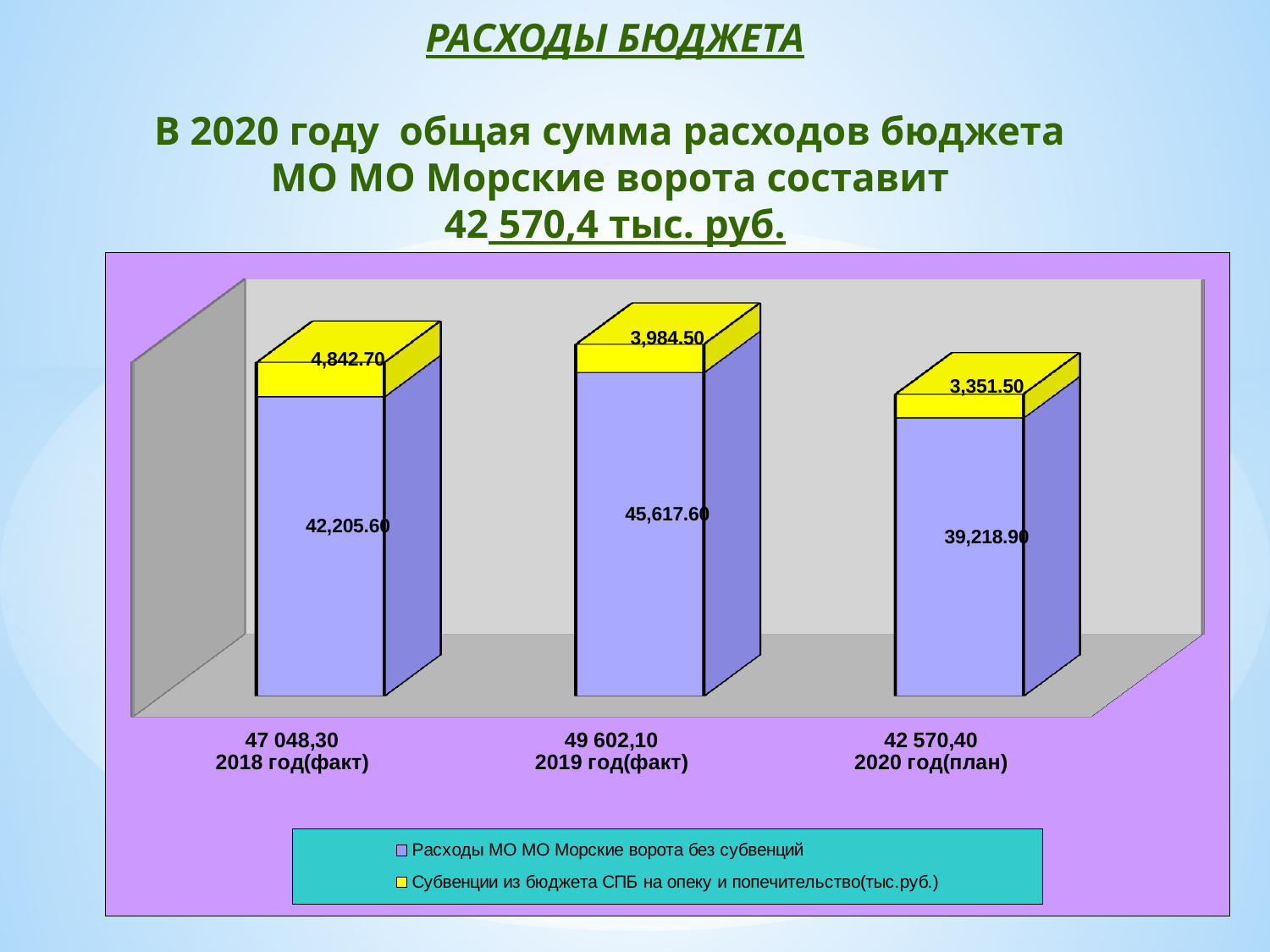
What is the value of 'Расходы МО МО Морские ворота без субвенций' for 2018 год(факт)? 42,205.60 What is the value of 'Субвенции из бюджета СПБ на опеку и попечительство(тыс.руб.)' for 2020 год(план)? 3,351.50 What is the total of the stacked bar for 2020 год(план)? 42,570.40 How many series does the legend list? 2 What kind of chart is shown on the slide? Stacked bar chart What is the value of 'Субвенции из бюджета СПБ на опеку и попечительство(тыс.руб.)' for 2019 год(факт)? 3,984.50 Which year has the highest value for 'Расходы МО МО Морские ворота без субвенций'? 2019 год(факт) What is the difference between the 'Расходы МО МО Морские ворота без субвенций' values for 2019 год(факт) and 2020 год(план)? 6,398.70 Is the 'Субвенции из бюджета СПБ на опеку и попечительство(тыс.руб.)' value larger for 2018 год(факт) or 2019 год(факт)? 2018 год(факт) How many categories (years) are shown on the chart? 3 Which year has the lowest value for 'Субвенции из бюджета СПБ на опеку и попечительство(тыс.руб.)'? 2020 год(план) What is the value of 'Расходы МО МО Морские ворота без субвенций' for 2020 год(план)? 39,218.90